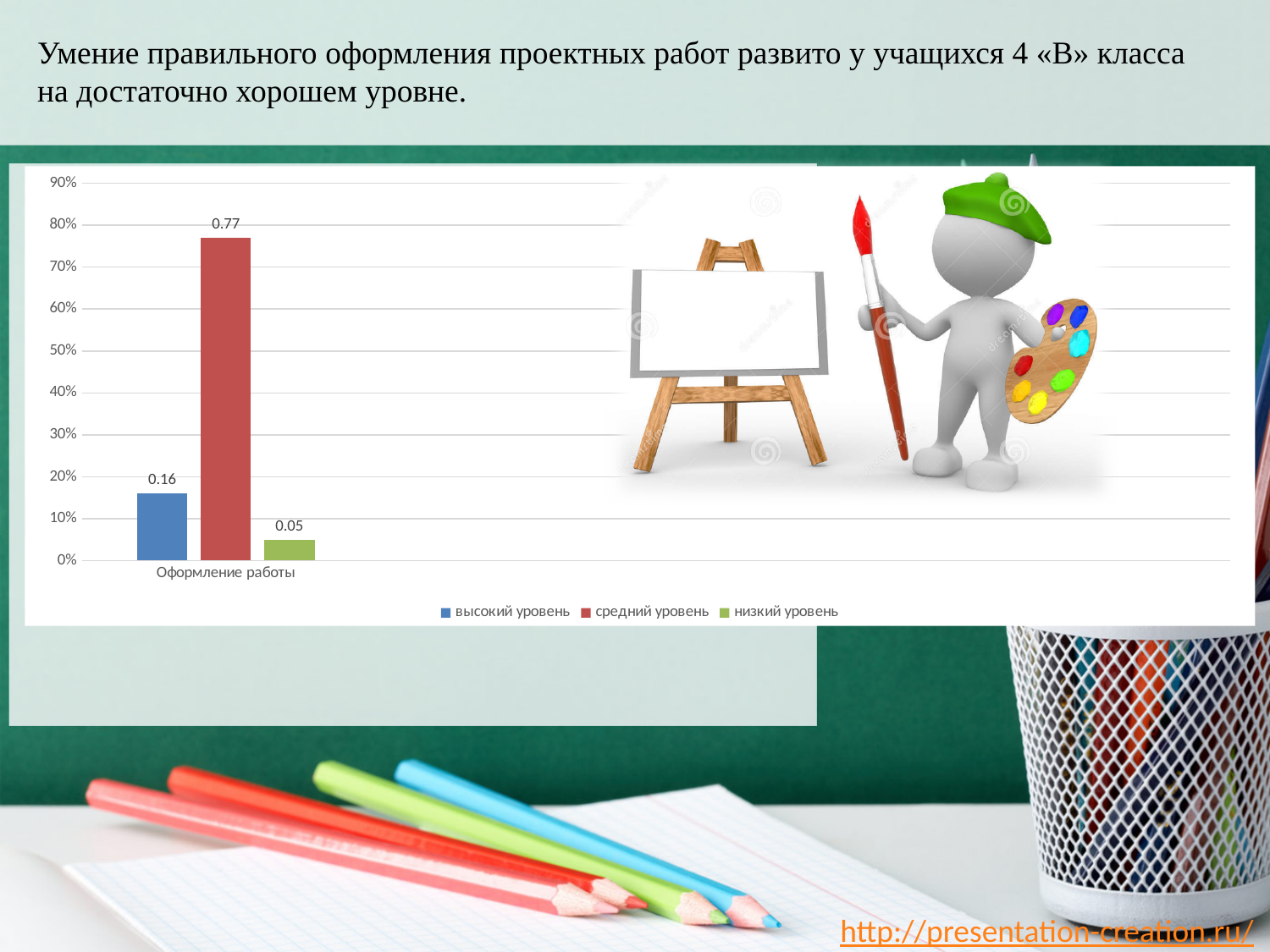
Which is larger, the value for "высокий уровень" or the value for "низкий уровень"? высокий уровень What is the value for the series "средний уровень" in the category "Оформление работы"? 0.77 What is the difference between the values for "высокий уровень" and "низкий уровень"? 0.11 What is the value for the series "высокий уровень" in the category "Оформление работы"? 0.16 What is the value for the series "низкий уровень" in the category "Оформление работы"? 0.05 Is the value for "средний уровень" greater or less than 70%? greater What is the difference between the values for "средний уровень" and "высокий уровень"? 0.61 What kind of chart is shown on the slide? bar chart What is the category label shown on the x axis of the chart? Оформление работы Which series has the lowest value in the chart? низкий уровень Which series has the highest value in the chart? средний уровень How many series does the legend list? 3